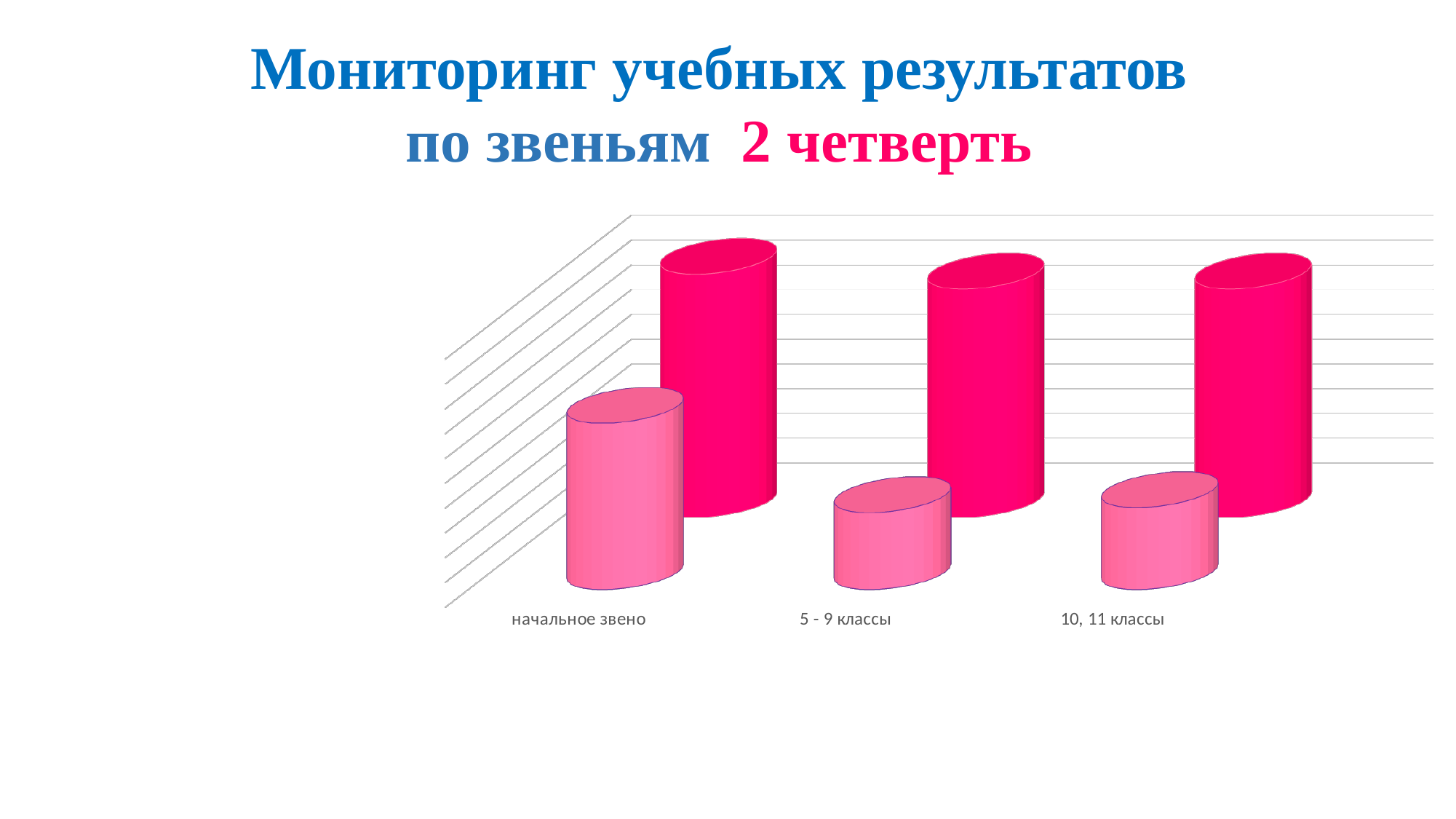
How many categories are shown on the x axis of the chart? 3 What kind of chart is shown on the slide? bar chart How many bars in total are plotted on the chart? 6 For the category начальное звено, which bar is taller: the dark pink (back) bar or the light pink (front) bar? dark pink (back) bar For the light pink (front) bars, which is larger: начальное звено or 10, 11 классы? начальное звено Among the dark pink (back) bars, which category has the highest value? начальное звено Among the light pink (front) bars, which category has the highest value? начальное звено For the category 5 - 9 классы, which bar is taller: the dark pink (back) bar or the light pink (front) bar? dark pink (back) bar Does the light pink (front) series rise or fall from начальное звено to 5 - 9 классы? fall What are the category labels on the x axis of the chart? начальное звено, 5 - 9 классы, 10, 11 классы What is the title of the slide containing the chart? Мониторинг учебных результатов по звеньям 2 четверть